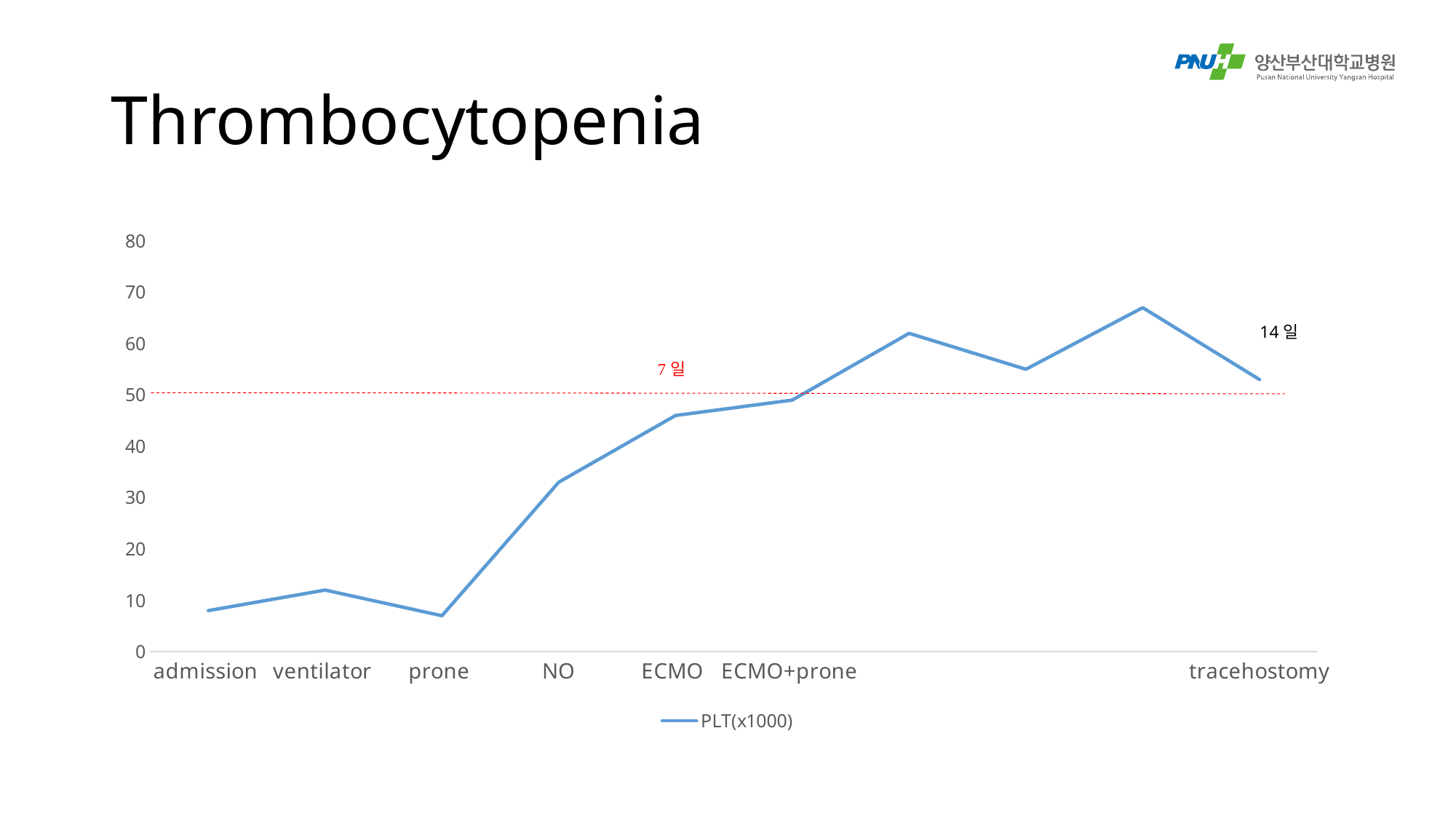
Is the value for ventilator greater or less than 10? greater Is the value for ECMO greater or less than 40? greater Is the value for tracehostomy greater or less than 60? less How many series does the legend list? 1 What is the name of the series shown in the legend? PLT(x1000) What is the title of the slide containing the chart? Thrombocytopenia Overall, does the PLT(x1000) value rise or fall from admission to tracehostomy? rise What kind of chart is shown on the slide? line chart Which has a higher value, NO or prone? NO